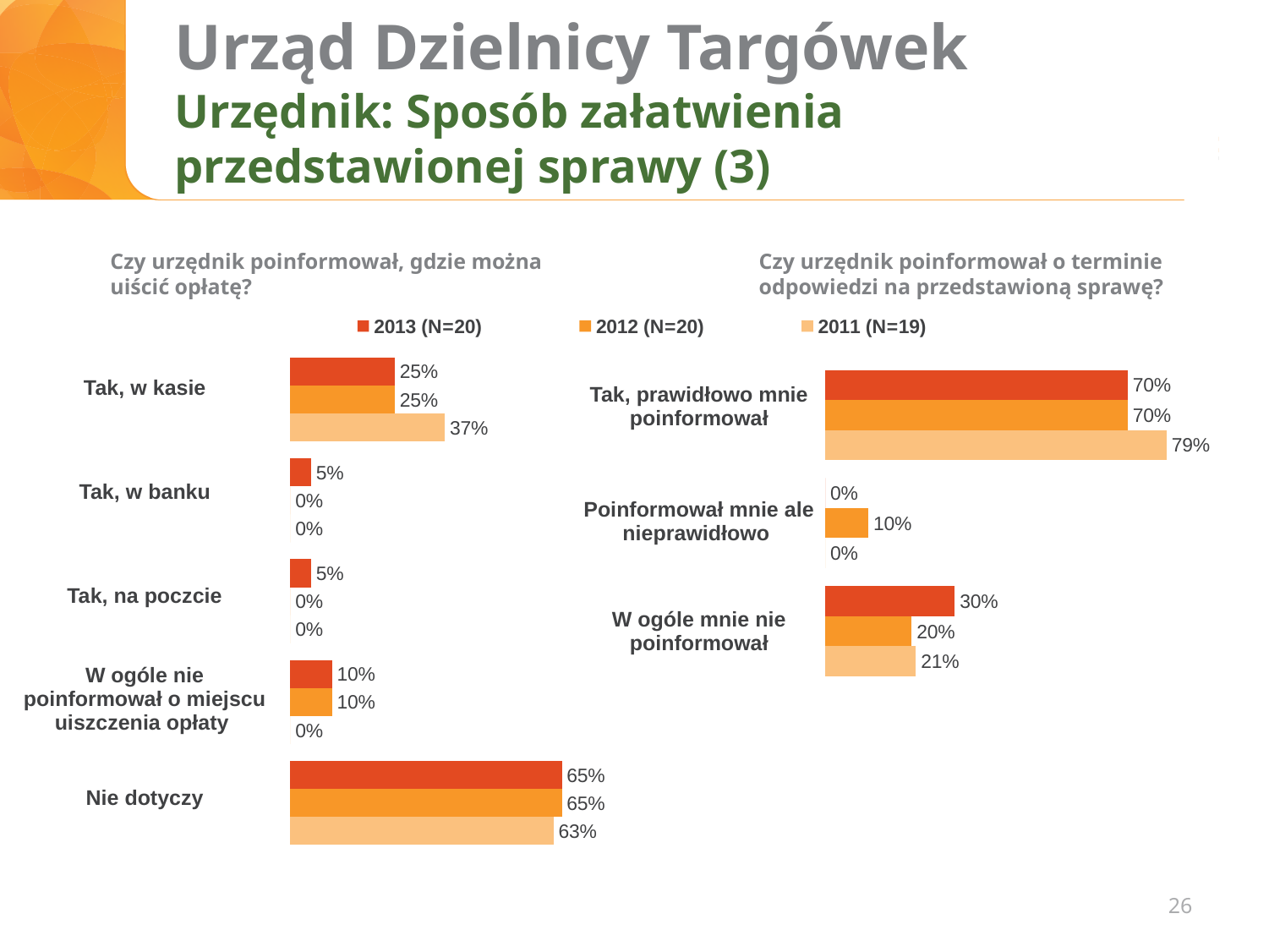
In the left chart ("Czy urzędnik poinformował, gdzie można uiścić opłatę?"), which category has the highest value in the 2012 (N=20) series? Nie dotyczy In the left chart ("Czy urzędnik poinformował, gdzie można uiścić opłatę?"), what is the difference between the 2011 (N=19) and 2013 (N=20) values for "Tak, w kasie"? 12 percentage points In the left chart ("Czy urzędnik poinformował, gdzie można uiścić opłatę?"), what is the value for "Nie dotyczy" in the 2013 (N=20) series? 65% In the left chart ("Czy urzędnik poinformował, gdzie można uiścić opłatę?"), what is the value for "Tak, w kasie" in the 2011 (N=19) series? 37% In the right chart ("Czy urzędnik poinformował o terminie odpowiedzi na przedstawioną sprawę?"), what is the difference between the 2013 (N=20) and 2012 (N=20) values for "W ogóle mnie nie poinformował"? 10 percentage points In the left chart ("Czy urzędnik poinformował, gdzie można uiścić opłatę?"), is the 2013 (N=20) value for "Tak, w banku" larger or smaller than the 2012 (N=20) value? larger In the right chart ("Czy urzędnik poinformował o terminie odpowiedzi na przedstawioną sprawę?"), which category has the lowest value in the 2012 (N=20) series? Poinformował mnie ale nieprawidłowo In the right chart ("Czy urzędnik poinformował o terminie odpowiedzi na przedstawioną sprawę?"), what is the value for "Tak, prawidłowo mnie poinformował" in the 2011 (N=19) series? 79% In the right chart ("Czy urzędnik poinformował o terminie odpowiedzi na przedstawioną sprawę?"), what is the value for "W ogóle mnie nie poinformował" in the 2013 (N=20) series? 30% In the left chart ("Czy urzędnik poinformował, gdzie można uiścić opłatę?"), how many categories are shown? 5 How many series does the legend list for the charts on this slide? 3 What type of chart is used on this slide? Bar chart